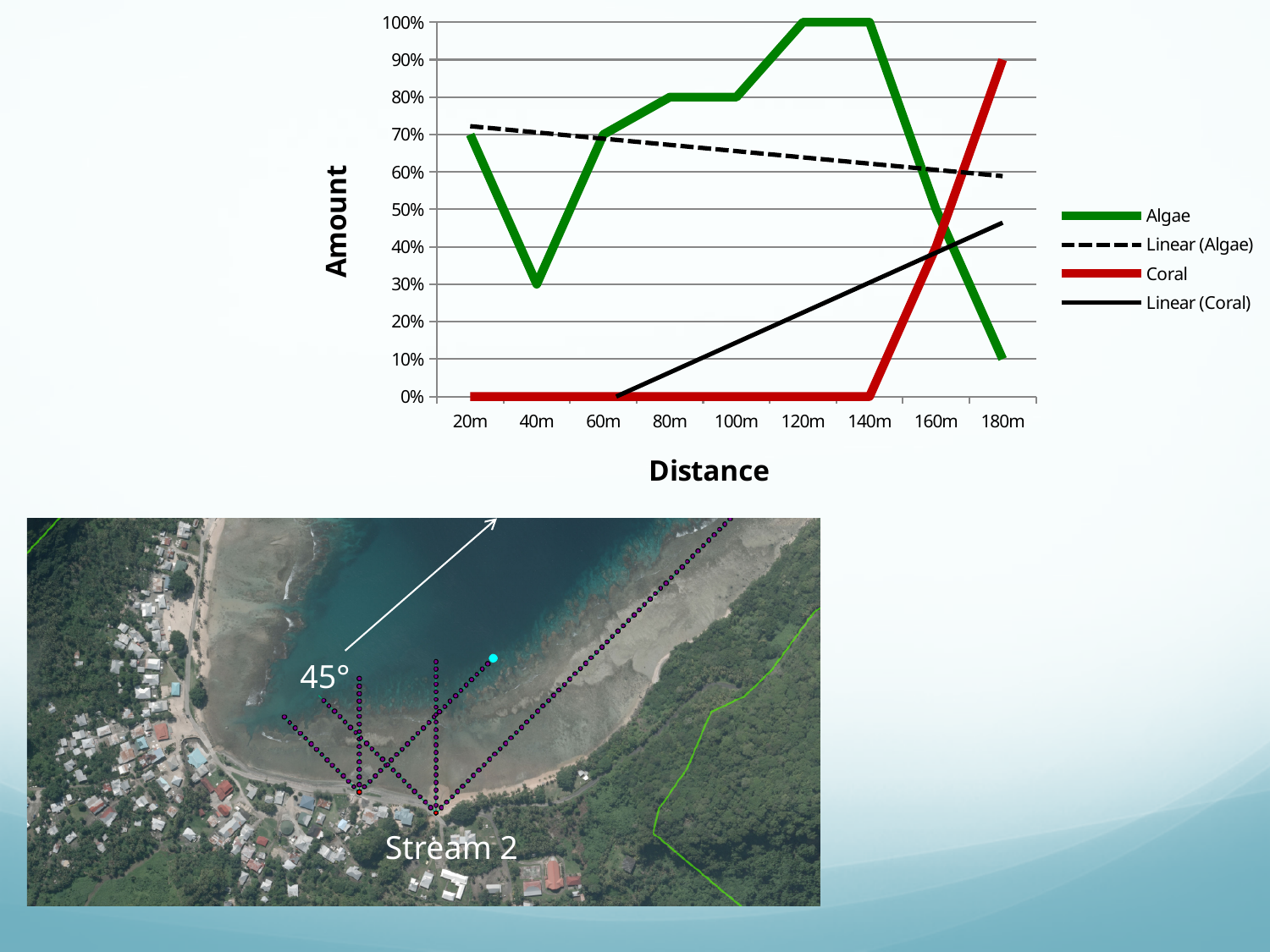
Does the Linear (Algae) trendline rise or fall as distance increases? fall What type of chart is shown on the slide? line chart How many series does the legend list? 4 What is the Algae value at 180m? 10% How many distance categories are shown on the x axis? 9 What is the Coral value at 180m? 90% Which is larger at 180m, Algae or Coral? Coral What is the Algae value at 40m? 30% At which distance is the Coral value highest? 180m At which distance is the Algae value lowest? 180m What is the Coral value at 100m? 0%